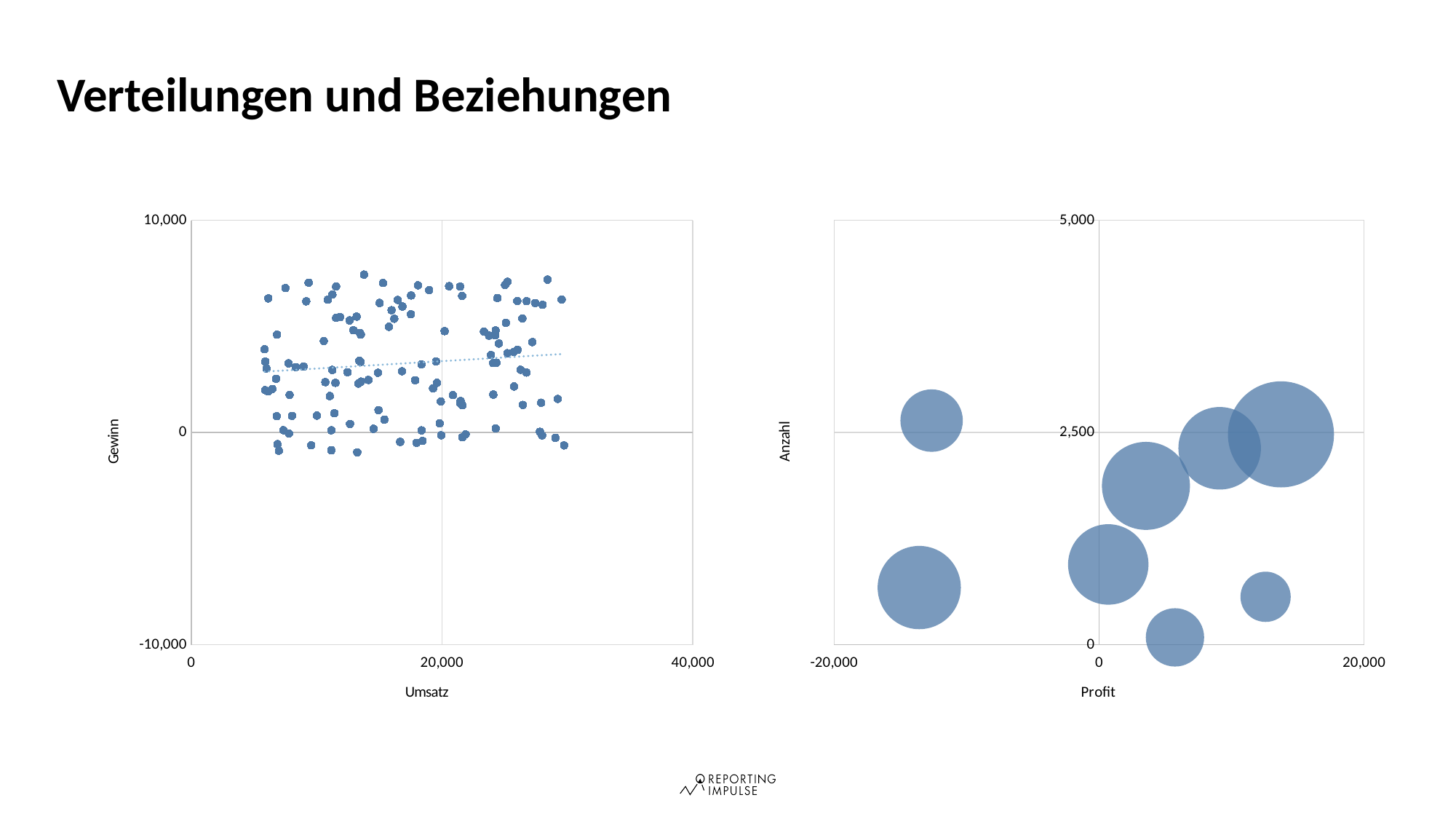
What kind of chart is the right chart with the Profit axis? bubble chart What is the label of the vertical axis on the left chart? Gewinn How many bubbles are plotted on the right chart? 8 On the left chart, is the highest Gewinn value plotted greater or less than 10,000? less On the right chart, how many bubbles lie at a Profit less than 0? 2 On the left chart, are all plotted points at an Umsatz less than 40,000? yes What kind of chart is the left chart with the Umsatz axis? scatter chart What is the label of the horizontal axis on the right chart? Profit On the right chart, is the Anzahl value of the smallest bubble greater or less than 2,500? less On the left chart, does the dotted trend line rise or fall as Umsatz increases? rises